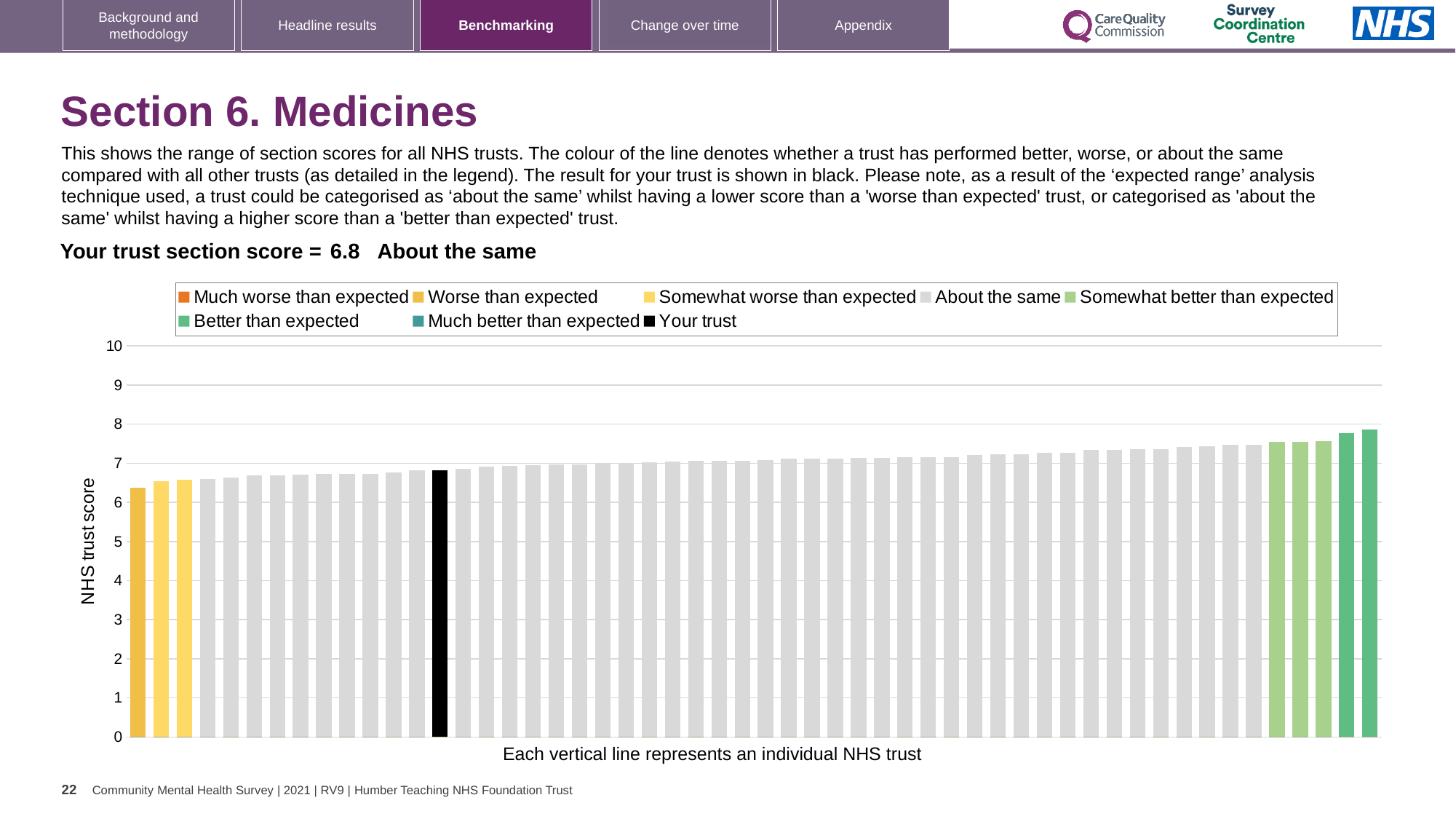
How many entries does the chart legend list? 8 Is the value of the tallest bar in the chart greater or less than 8? less According to the legend, what colour represents 'Your trust'? black Which category is your trust placed in for the Medicines section? About the same Is the value for your trust (the black bar) greater or less than 5? greater Is the value of the shortest bar in the chart greater or less than 6? greater How many black bars are there in the chart? 1 Is the black bar for your trust taller or shorter than the leftmost bar? taller Do the bar values rise or fall from left to right across the chart? rise What is the section score for your trust shown on the slide? 6.8 What is the label on the vertical axis of the chart? NHS trust score What kind of chart is shown on the slide? bar chart